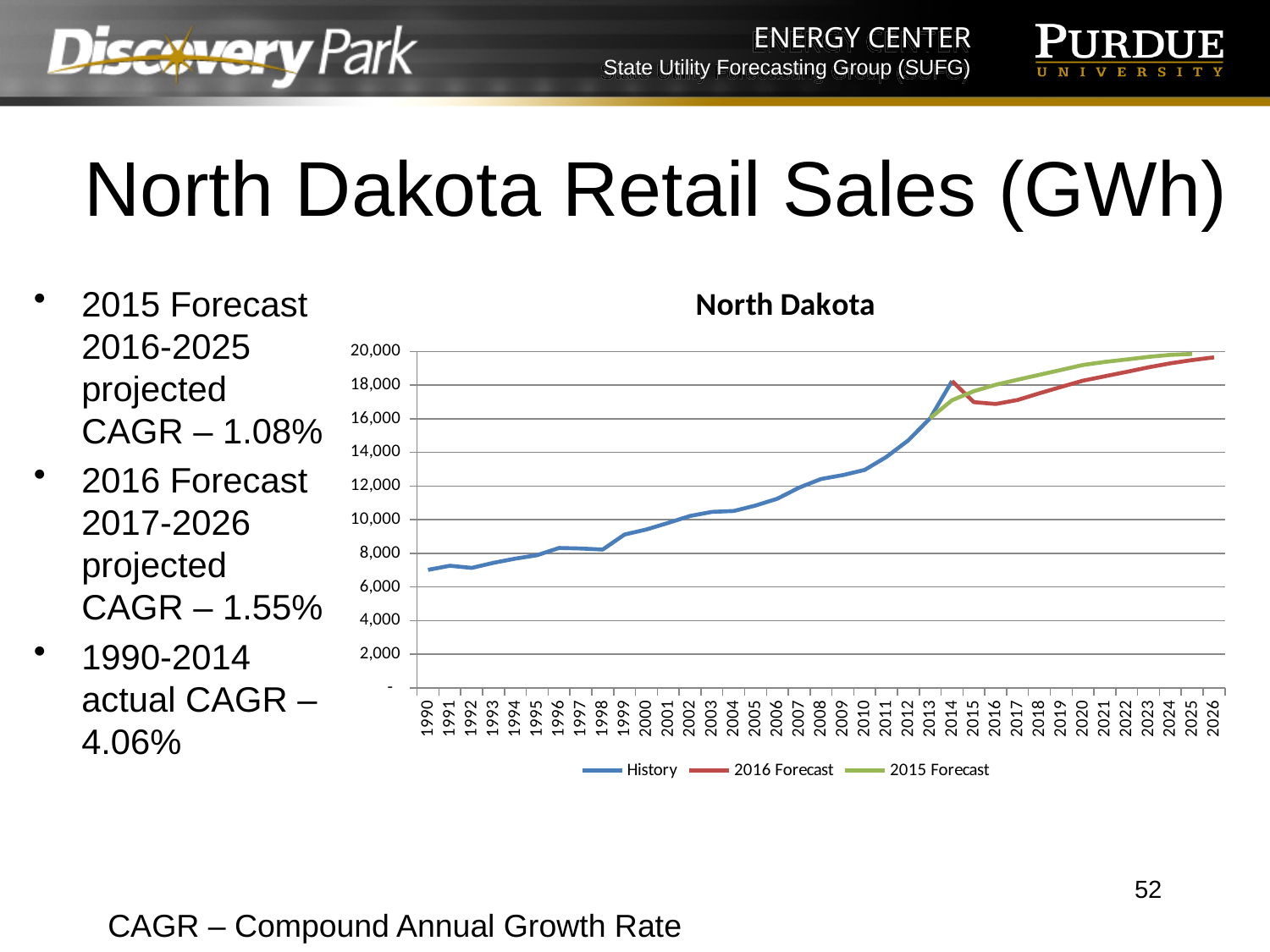
Is the History value for 1990 greater or less than 6,000? greater Is the 2016 Forecast value for 2016 greater or less than 18,000? less Does the History series rise or fall from 1990 to 2014? rise How many series does the chart legend list? 3 Is the History value for 2010 greater or less than 12,000? greater In 2020, which series is higher: 2015 Forecast or 2016 Forecast? 2015 Forecast What kind of chart is shown on the slide? line chart Which series is drawn in green in the chart? 2015 Forecast What is the title of the chart? North Dakota How many years are labelled along the x axis of the chart? 37